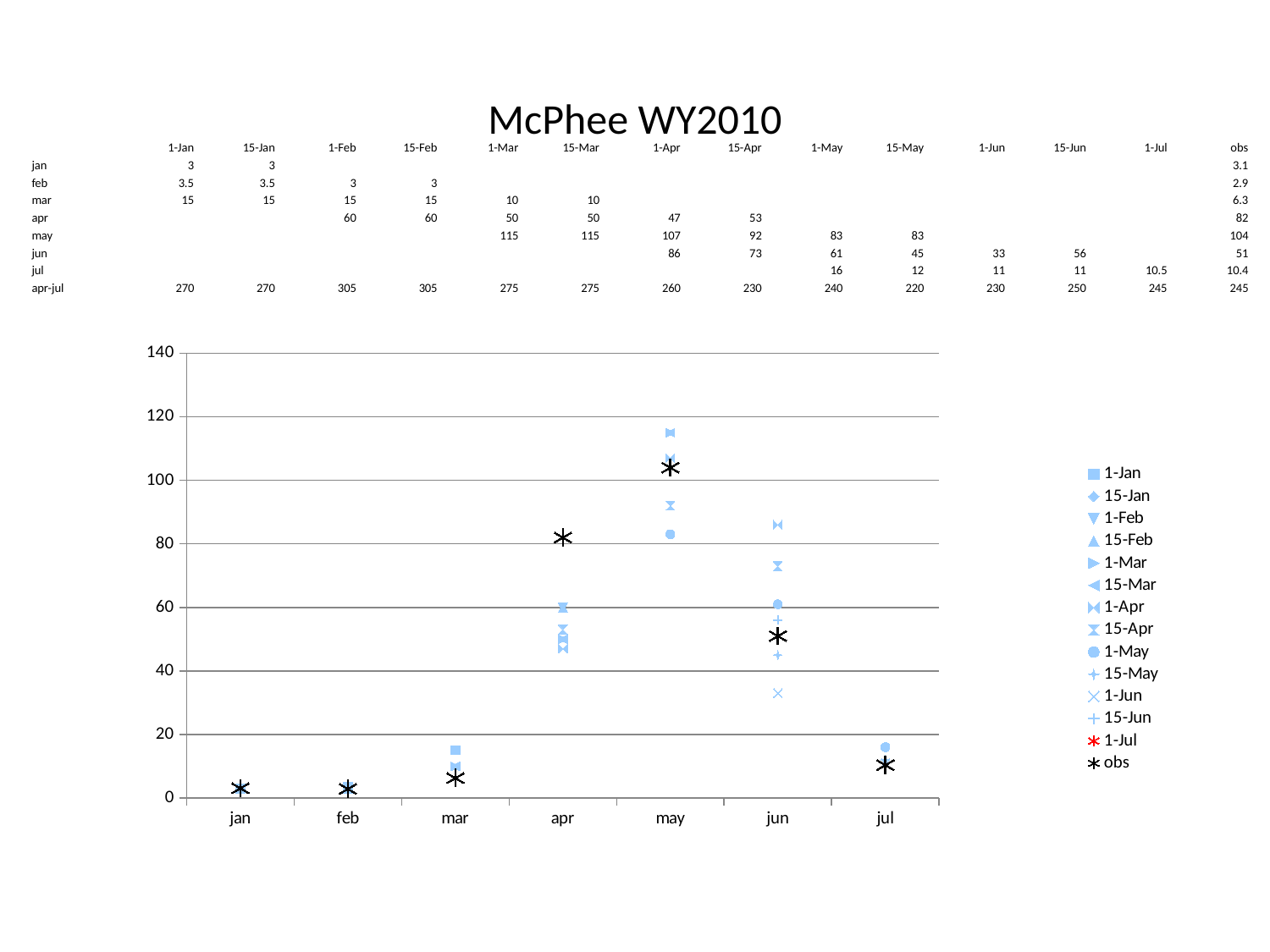
Is the 1-Jun value for jun greater or less than 40? less What is the obs value for apr? 82 What kind of chart is shown on the slide? scatter chart Is the 1-Apr value for may greater or less than 100? greater What is the obs value for may? 104 How many series does the chart legend list? 14 In which month does the obs series reach its highest value? may Does the obs series rise or fall from jan to may? rise How many categories are on the x axis of the chart? 7 What is the title of the chart? McPhee WY2010 What is the difference between the obs value for may and the obs value for apr? 22 Which is larger, the obs value for may or the obs value for jun? may